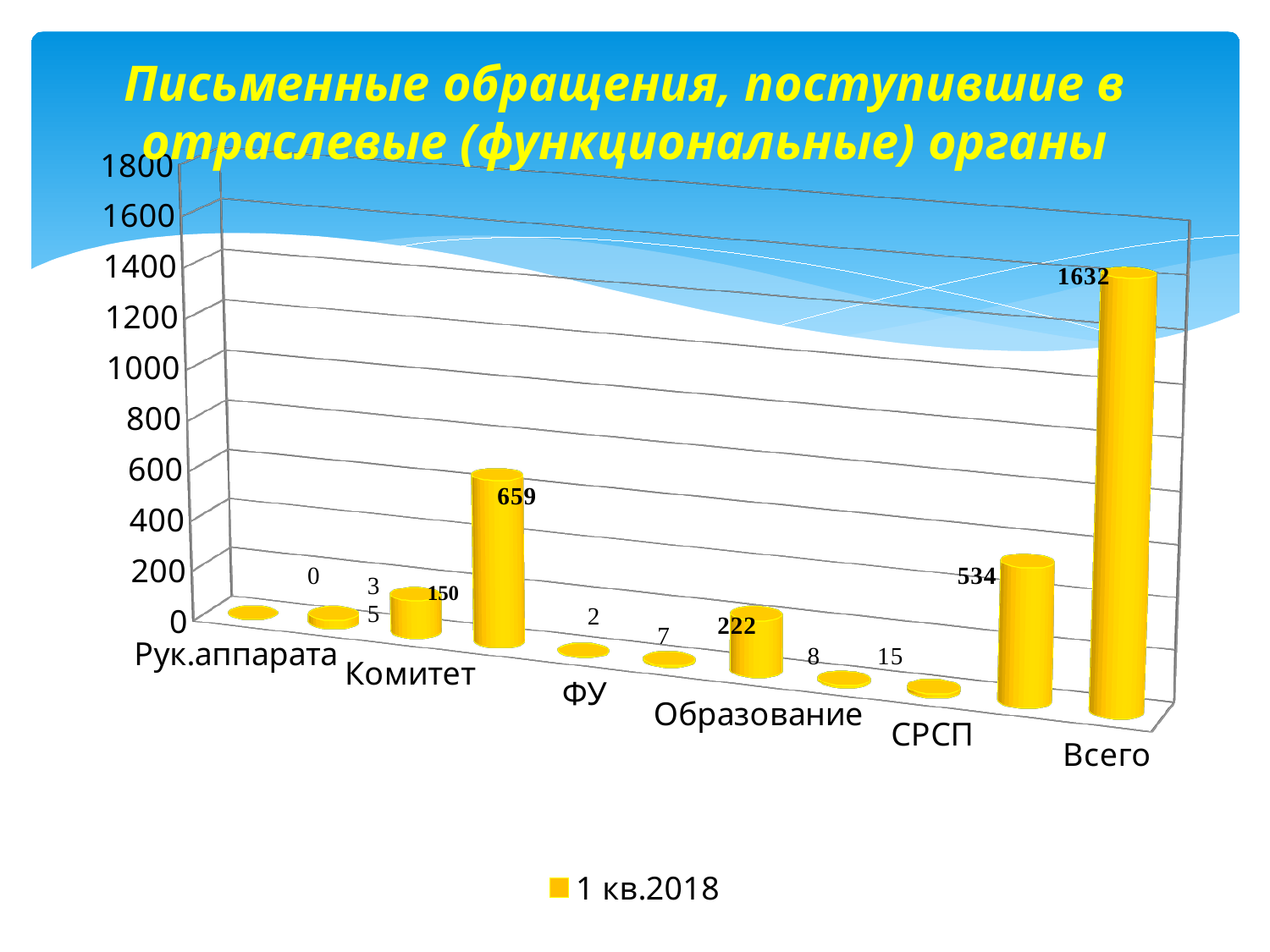
What is the title of the chart? Письменные обращения, поступившие в отраслевые (функциональные) органы Which is larger, the bar labelled 659 or the bar labelled 534? 659 How many series does the legend list? 1 What is the difference between the bar labelled 1632 and the bar labelled 659? 973 What is the lowest value labelled in the chart? 0 Is the value for Всего greater or less than 1400? greater What is the highest value shown in the chart? 1632 What kind of chart is shown on the slide? bar chart What is the value of the bar for Всего? 1632 How many bars are plotted in the chart? 11 What is the legend entry for the series? 1 кв.2018 Which category has the highest value? Всего